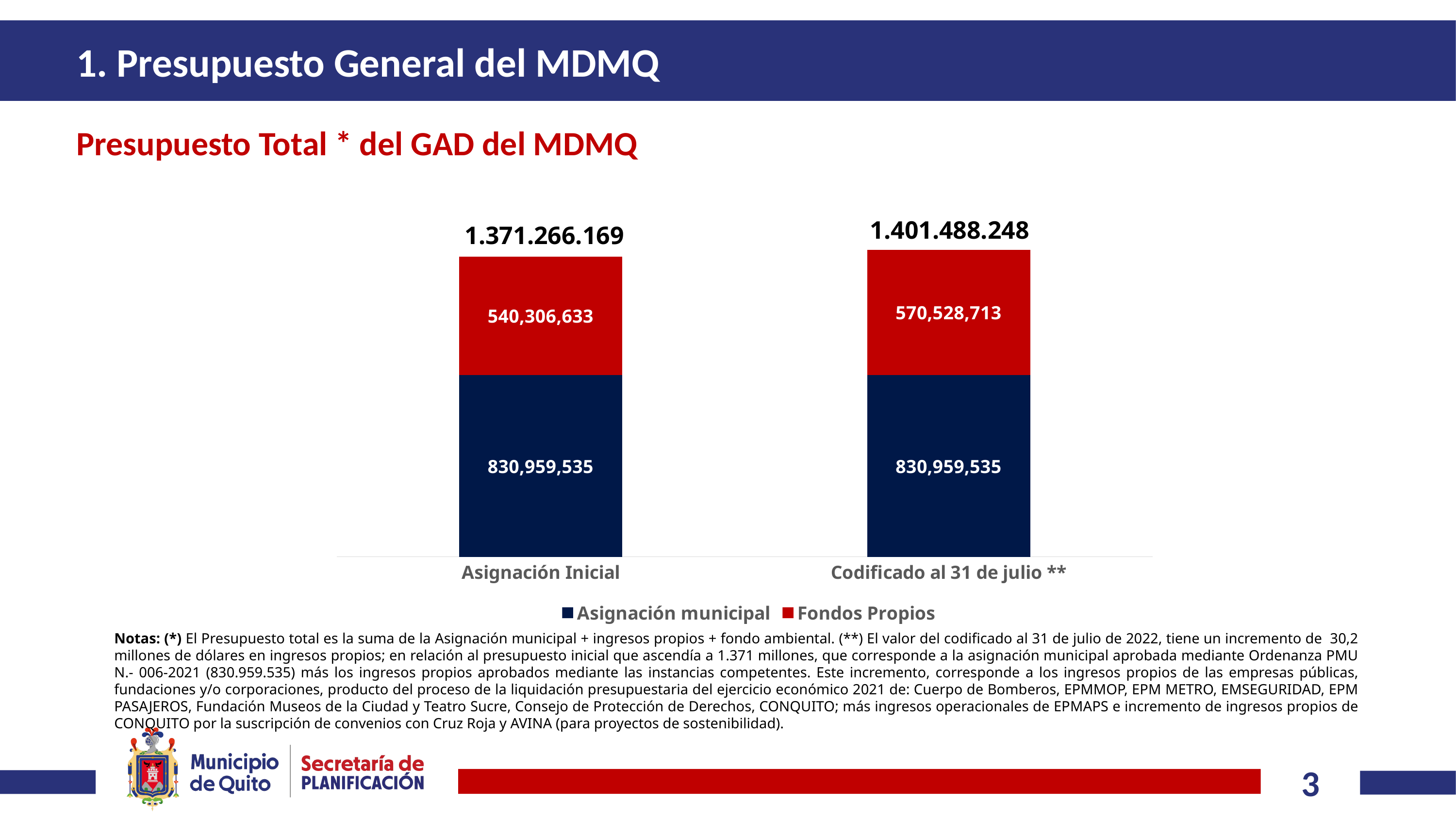
What is the value of Fondos Propios for Asignación Inicial? 540,306,633 How many series does the legend list? 2 What is the total shown above the Codificado al 31 de julio ** bar? 1.401.488.248 What is the value of Asignación municipal for Codificado al 31 de julio **? 830,959,535 What kind of chart is shown on the slide? Stacked bar chart How many categories are shown on the x axis? 2 Which category has the lower total budget? Asignación Inicial Within the Asignación Inicial bar, which is larger: Asignación municipal or Fondos Propios? Asignación municipal What is the total shown above the Asignación Inicial bar? 1.371.266.169 What is the value of Fondos Propios for Codificado al 31 de julio **? 570,528,713 What is the difference in Fondos Propios between Codificado al 31 de julio ** and Asignación Inicial? 30,222,080 Which category has the higher Fondos Propios value? Codificado al 31 de julio **